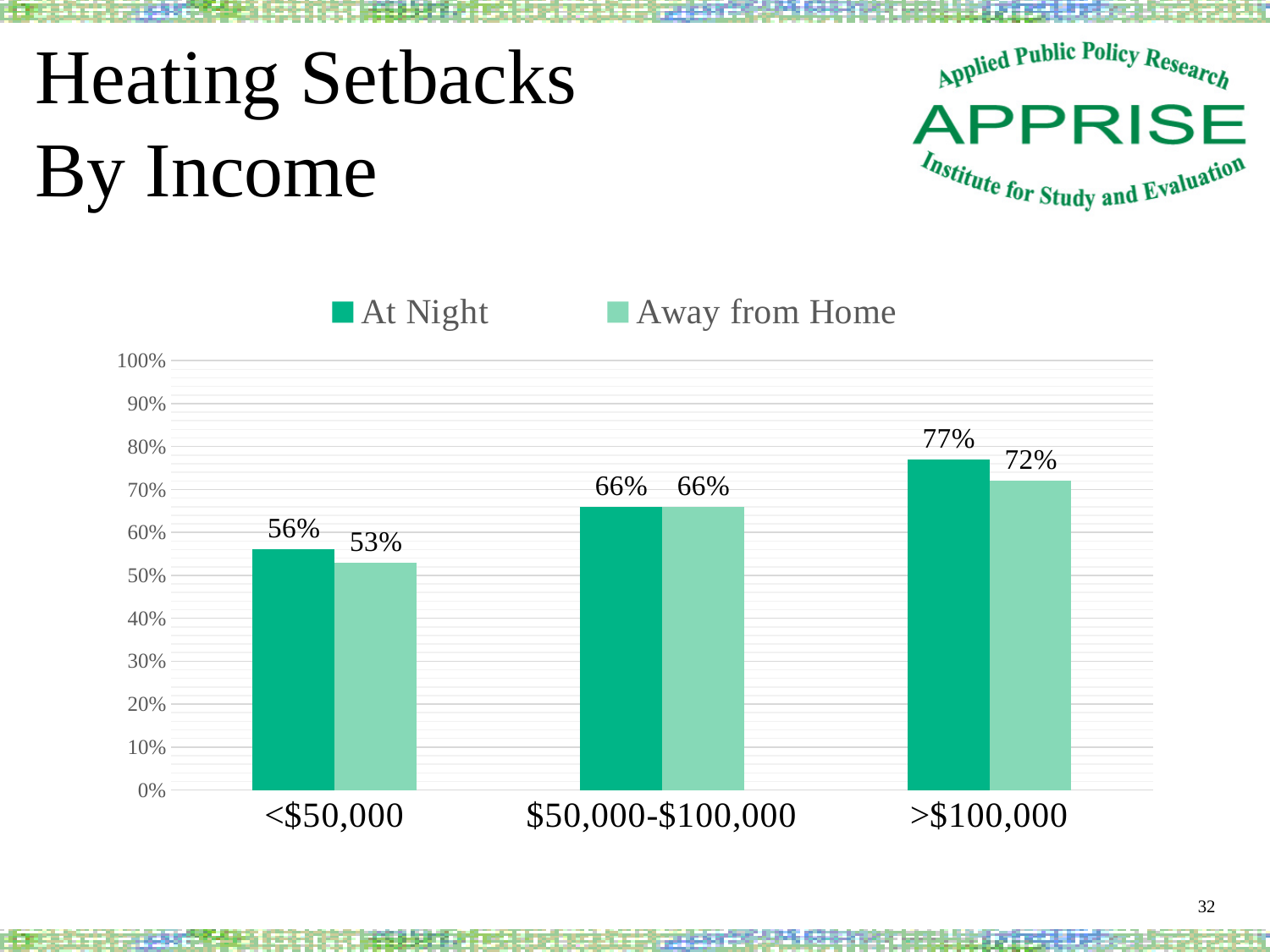
What is the At Night value for the <$50,000 income group? 56% Which is larger for the <$50,000 income group: At Night or Away from Home? At Night How many series does the legend list? 2 How many income groups are shown on the x axis? 3 What kind of chart is shown on the slide? Bar chart What is the difference between the At Night values for the >$100,000 and <$50,000 income groups? 21% Do the At Night values rise or fall as income increases along the x axis? Rise What is the difference between the At Night and Away from Home values for the >$100,000 income group? 5% Which income group has the highest At Night value? >$100,000 What is the Away from Home value for the >$100,000 income group? 72% What is the Away from Home value for the $50,000-$100,000 income group? 66% Which income group has the lowest Away from Home value? <$50,000